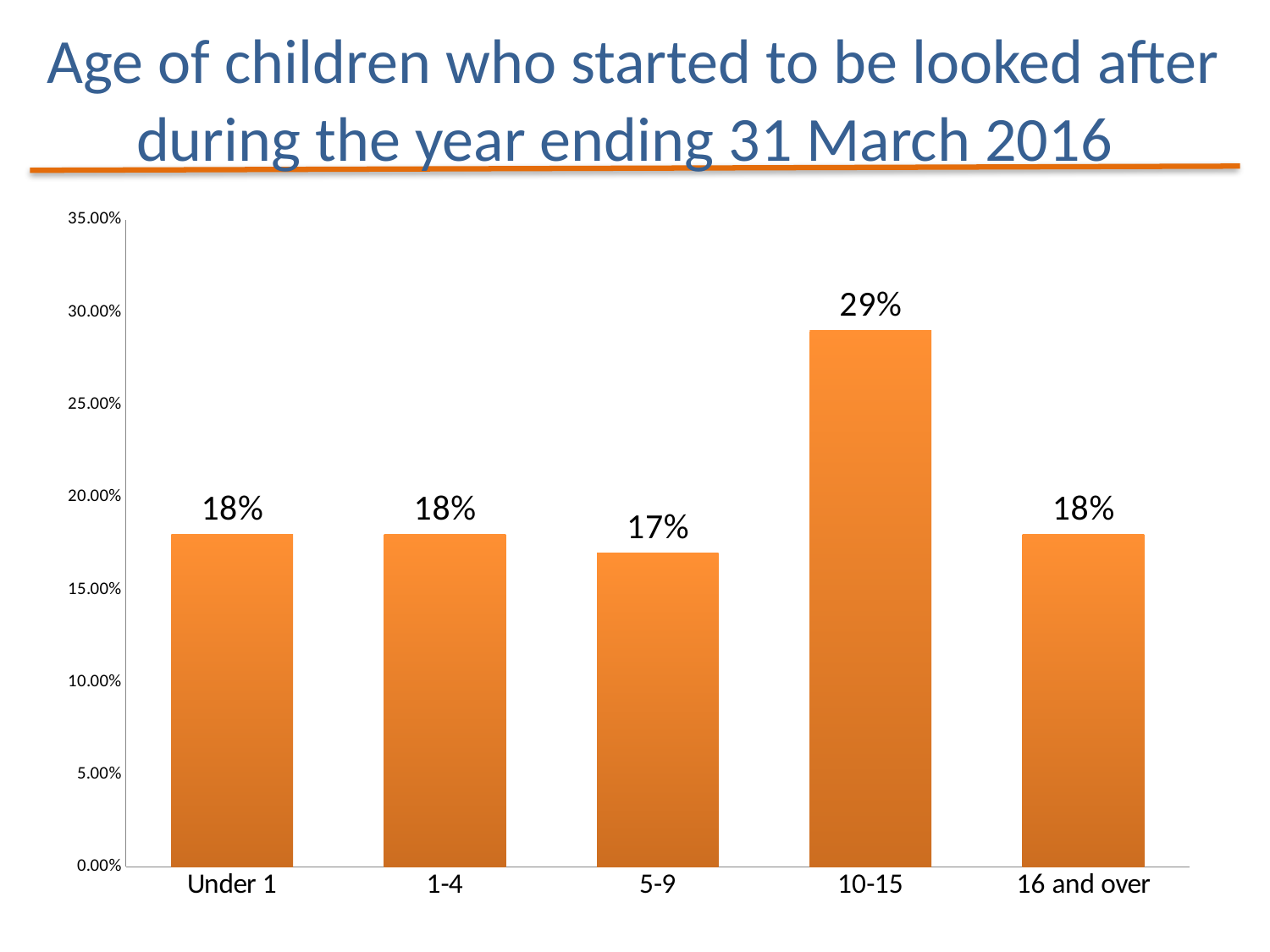
What is the value for the 10-15 age group? 29% How many age groups are shown on the chart? 5 Which age group has the highest value? 10-15 Which is larger, the value for 10-15 or the value for 1-4? 10-15 Is the value for 10-15 greater or less than 25.00%? greater What is the value for the Under 1 age group? 18% What is the value for the 16 and over age group? 18% What kind of chart is shown on the slide? Bar chart What is the value for the 5-9 age group? 17% What is the title of the slide? Age of children who started to be looked after during the year ending 31 March 2016 Which age group has the lowest value? 5-9 What is the difference between the values for 10-15 and 5-9? 12%